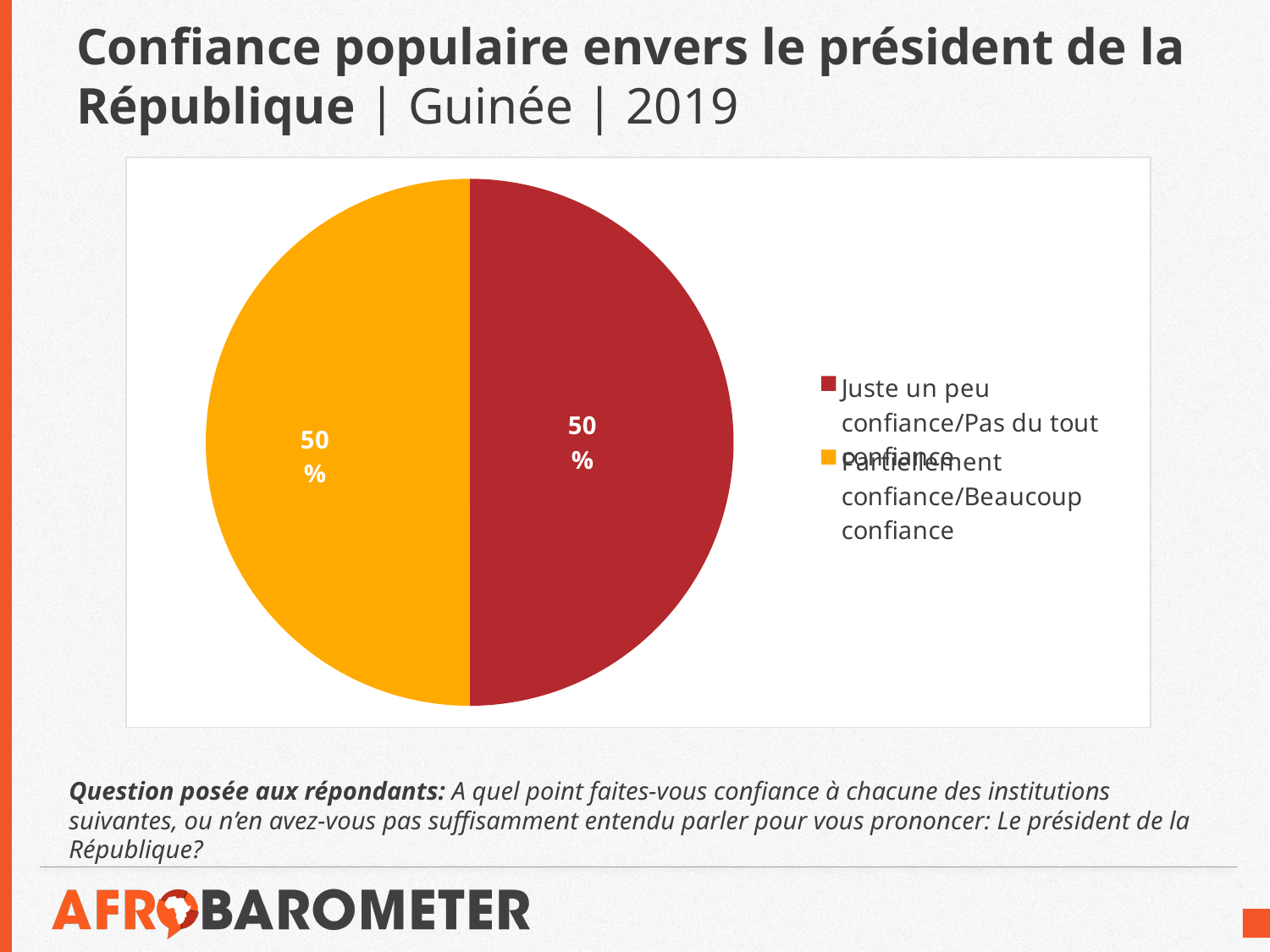
What kind of chart is shown on the slide? Pie chart What is the difference between the 'Juste un peu confiance/Pas du tout confiance' share and the 'Partiellement confiance/Beaucoup confiance' share? 0 percentage points Which country and year does the chart title refer to? Guinée, 2019 What share of the pie does the 'Partiellement confiance/Beaucoup confiance' slice represent? 50% Is the value for 'Juste un peu confiance/Pas du tout confiance' greater or less than 25%? greater Which colour represents 'Partiellement confiance/Beaucoup confiance' in the pie chart? Yellow What percentage of respondents have 'Partiellement confiance/Beaucoup confiance' in the president? 50% What percentage of respondents have 'Juste un peu confiance/Pas du tout confiance' in the president? 50% How many slices does the pie chart have? 2 How many entries does the legend list? 2 What share of the pie does the 'Juste un peu confiance/Pas du tout confiance' slice represent? 50%